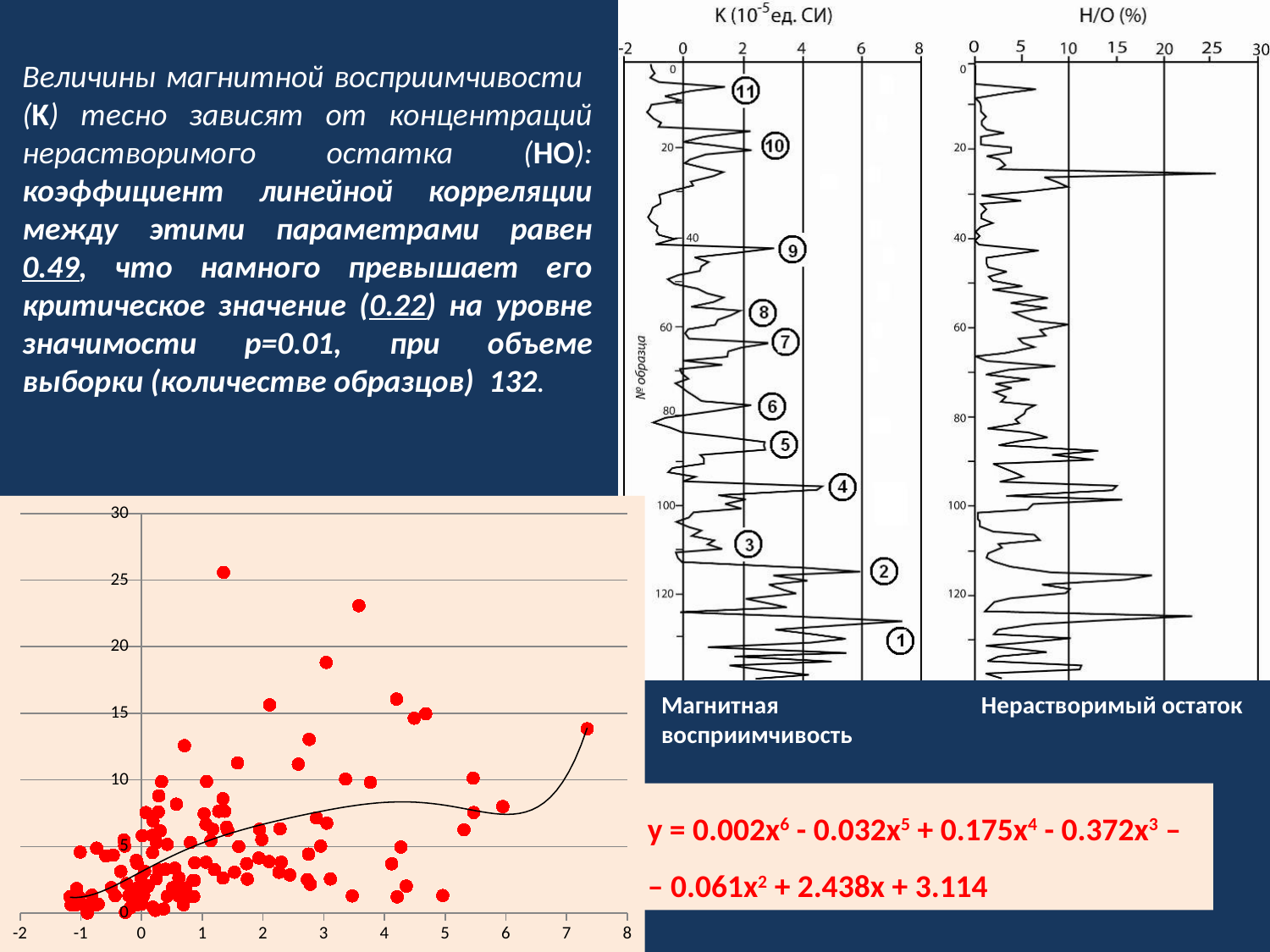
In the Нерастворимый остаток chart, is the value at sample 0 greater or less than 5? less What is the axis label at the top of the Нерастворимый остаток chart? Н/О (%) What is the caption under the left of the two right-hand charts? Магнитная восприимчивость In the Нерастворимый остаток chart, is the peak value near sample 25 greater or less than 20? greater What kind of charts are the two charts on the right side of the slide (Магнитная восприимчивость and Нерастворимый остаток)? line charts In the bottom-left scatter chart, is the y value of the rightmost point (near x = 7) greater or less than 10? greater What kind of chart is shown in the bottom-left of the slide? scatter chart In the bottom-left scatter chart, does the fitted curve overall rise or fall from left to right? rises In the Магнитная восприимчивость chart, how many numbered circle markers are placed along the curve? 11